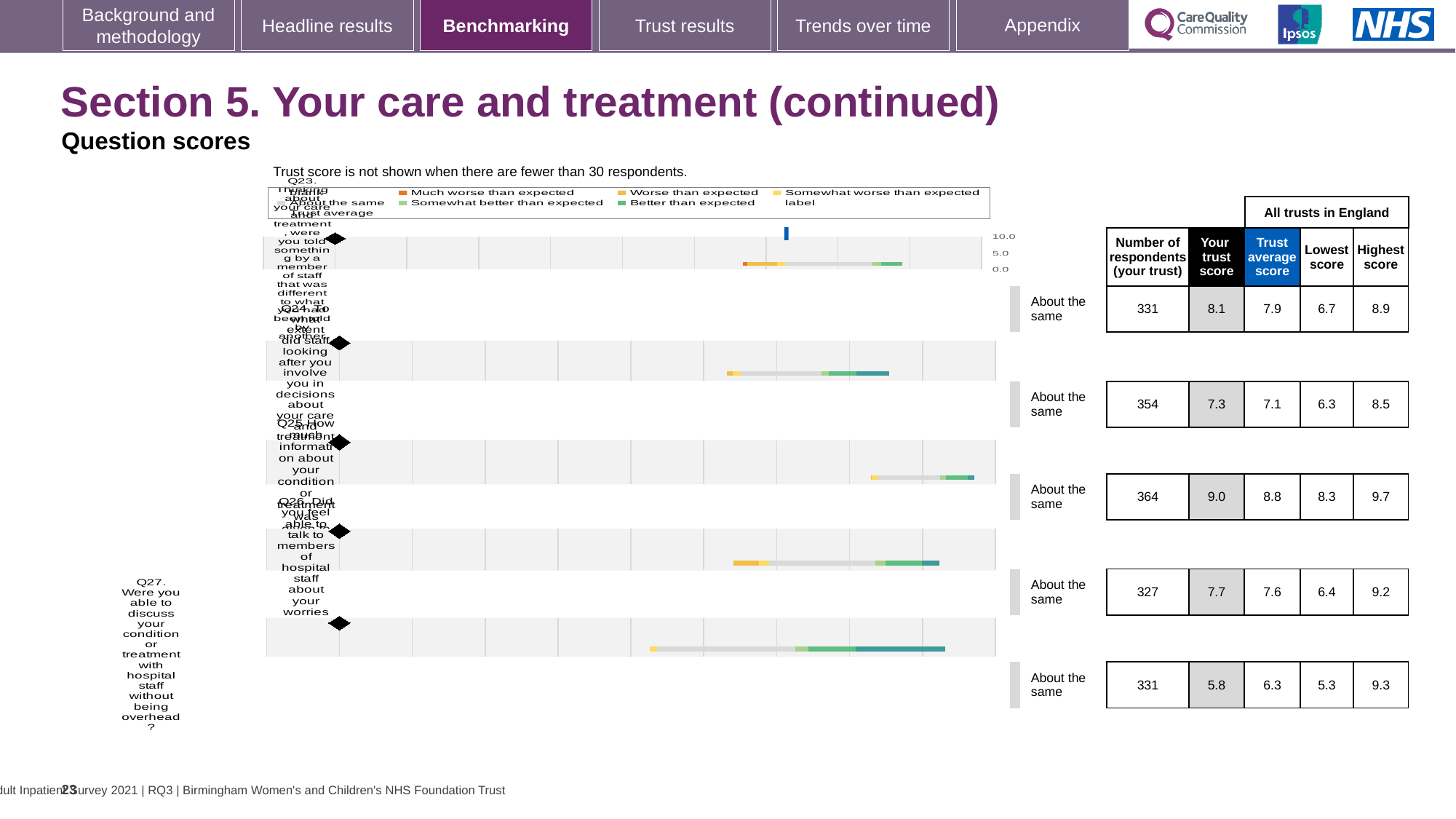
How many respondents from your trust answered Q27 (able to discuss your condition or treatment without being overheard)? 331 For Q23, how much higher is 'Your trust score' than the trust average score? 0.2 For Q24, which is larger: 'Your trust score' or the trust average score? Your trust score Which question has the highest 'Your trust score' on this slide? Q25 For Q27, what is the difference between the highest score and the lowest score across all trusts in England? 4.0 What kind of chart is used to show the question scores on this slide? Bar chart What is the 'Your trust score' for Q25 (how much information about your condition or treatment was given)? 9.0 What is the trust average score for Q26 (able to talk to members of hospital staff about your worries)? 7.6 How many questions are shown on this slide's chart? 5 What is the highest score across all trusts in England for Q24 (did staff involve you in decisions about your care and treatment)? 8.5 What benchmark category is shown next to each question on this slide? About the same Which question has the lowest 'Your trust score' on this slide? Q27